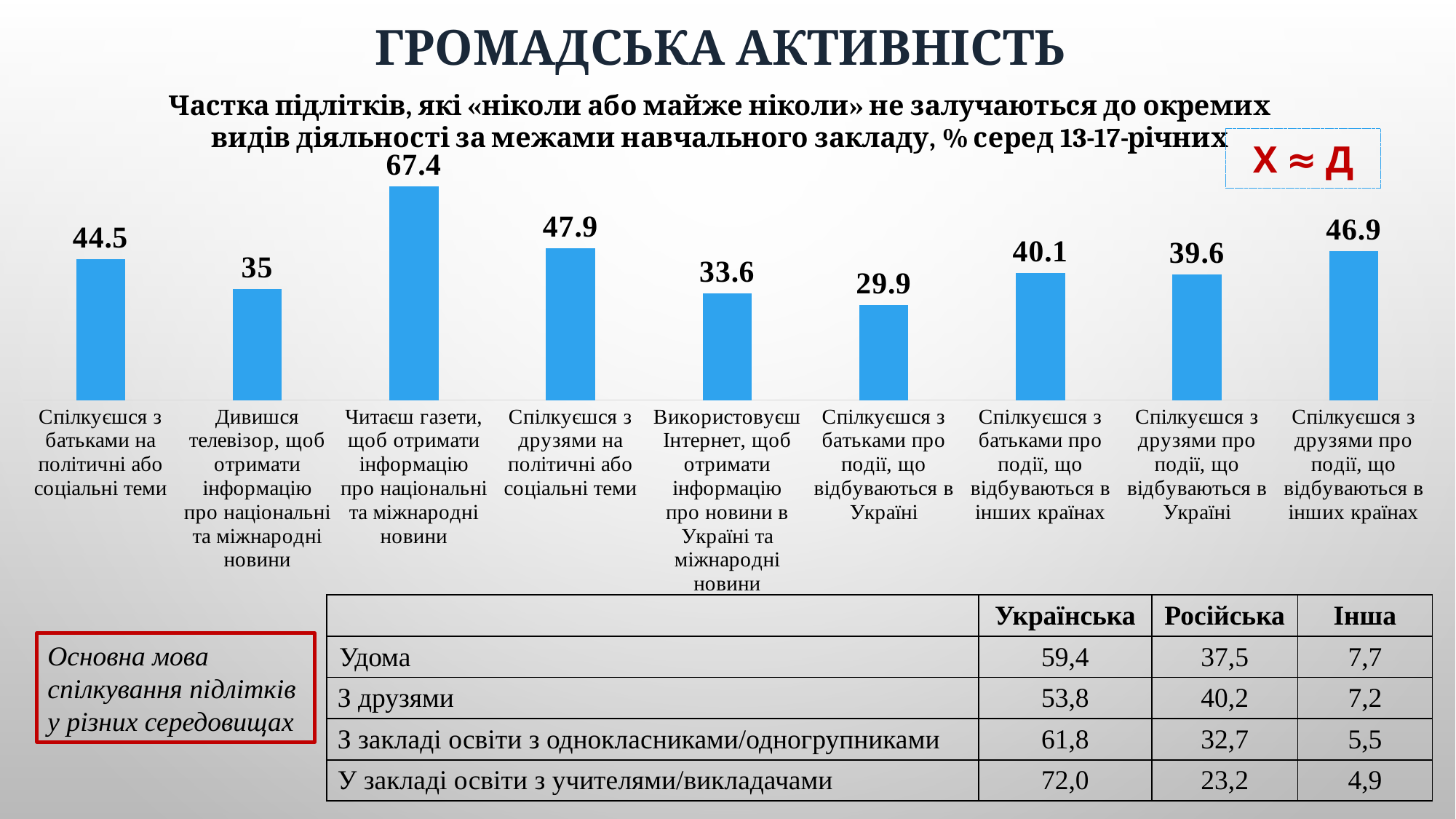
What colour are the bars in the chart? Blue What is the value for «Дивишся телевізор, щоб отримати інформацію про національні та міжнародні новини»? 35 How many categories (bars) does the chart show? 9 What is the value for «Використовуєш Інтернет, щоб отримати інформацію про новини в Україні та міжнародні новини»? 33.6 Which is larger: the value for «Спілкуєшся з батьками на політичні або соціальні теми» or for «Спілкуєшся з друзями на політичні або соціальні теми»? Спілкуєшся з друзями на політичні або соціальні теми What is the value for «Спілкуєшся з батьками про події, що відбуваються в Україні»? 29.9 What is the difference between the values for «Читаєш газети...» (67.4) and «Спілкуєшся з друзями на політичні або соціальні теми» (47.9)? 19.5 What is the value for «Читаєш газети, щоб отримати інформацію про національні та міжнародні новини»? 67.4 What kind of chart is shown on the slide? Bar chart What is the difference between «Спілкуєшся з батьками про події, що відбуваються в інших країнах» and «Спілкуєшся з батьками про події, що відбуваються в Україні»? 10.2 Which category has the lowest value in the chart? Спілкуєшся з батьками про події, що відбуваються в Україні Which category has the highest value in the chart? Читаєш газети, щоб отримати інформацію про національні та міжнародні новини